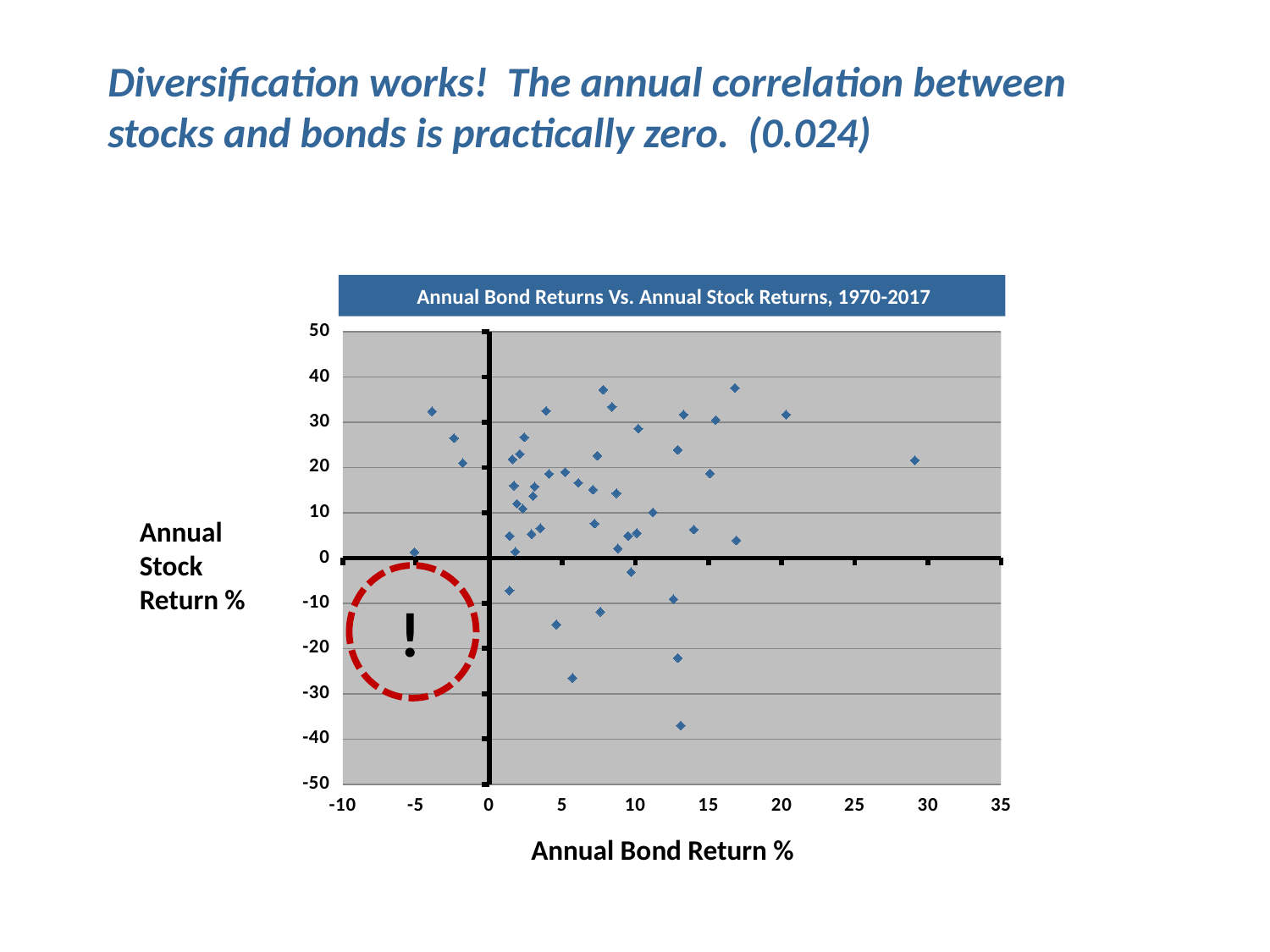
Is the lowest annual bond return plotted on the chart greater or less than 0? less What is the minimum value shown on the horizontal axis of the chart? -10 What is the label of the horizontal axis of the chart? Annual Bond Return % Is the highest annual stock return plotted on the chart greater or less than 40? less What kind of chart is shown on the slide? scatter plot Is the highest annual bond return plotted on the chart greater or less than 25? greater What is the maximum value shown on the vertical axis of the chart? 50 What is the title of the chart? Annual Bond Returns Vs. Annual Stock Returns, 1970-2017